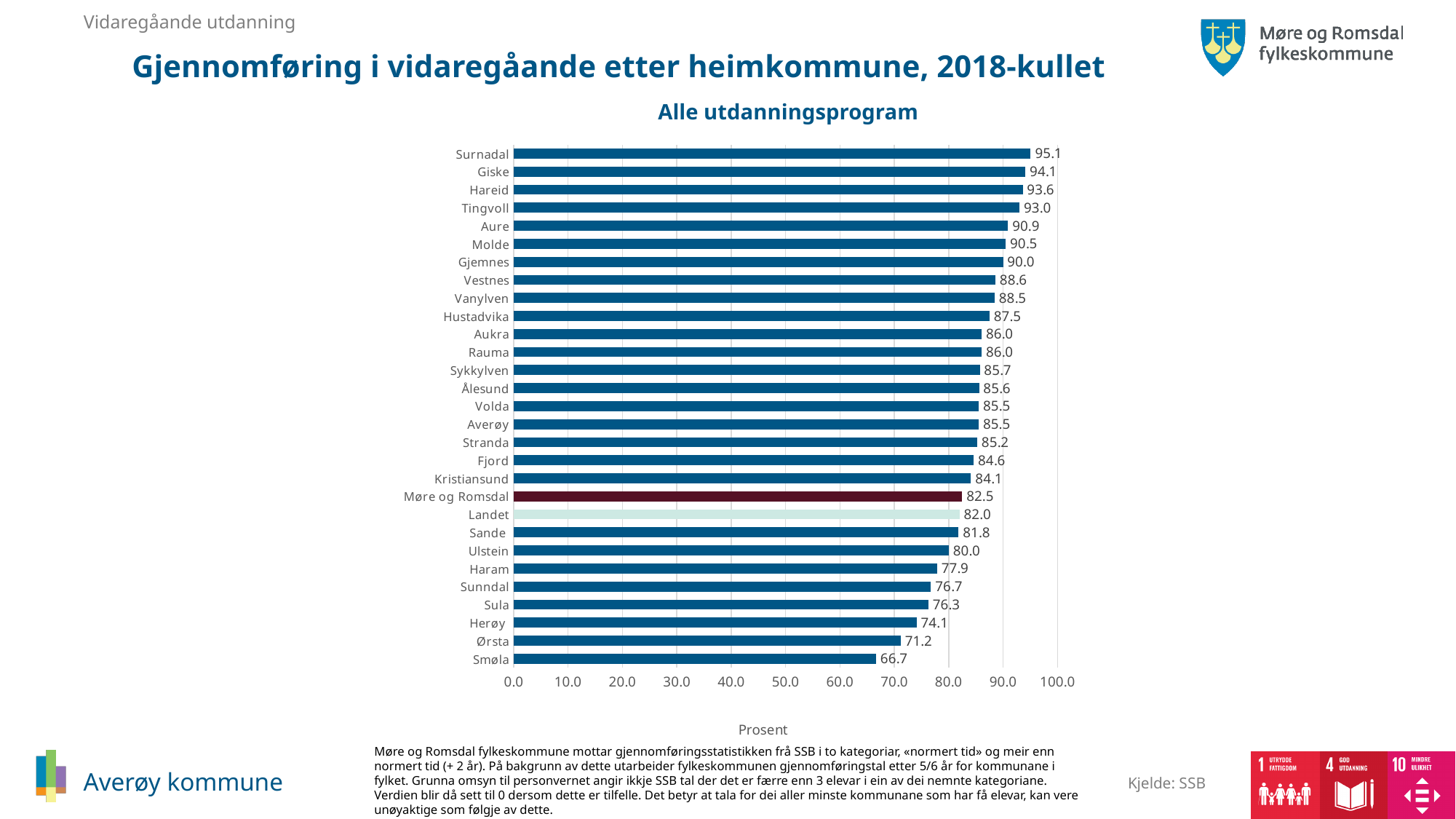
What is the value for Møre og Romsdal? 82.5 Is the value for Ørsta greater or less than 80.0? less What is the label on the horizontal axis of the chart? Prosent Which category has the highest value? Surnadal Which has a larger value, Molde or Kristiansund? Molde What is the difference between the values for Averøy and Møre og Romsdal? 3.0 What kind of chart is shown on the slide? bar chart What is the value for Landet? 82.0 What is the difference between the values for Surnadal and Smøla? 28.4 How many categories are shown in the chart? 29 Which category has the lowest value? Smøla What is the value for Averøy? 85.5